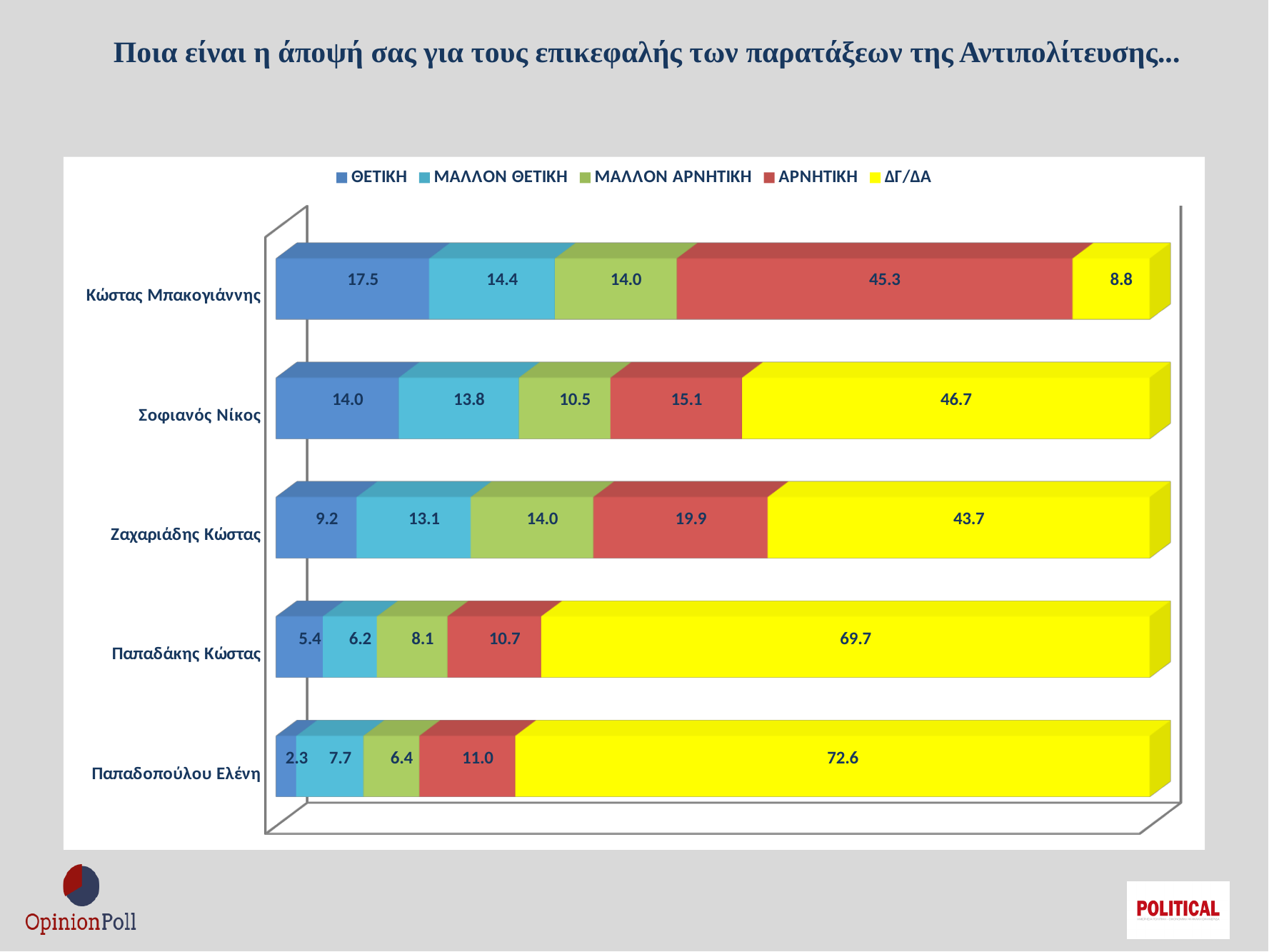
What kind of chart is shown on the slide? Stacked bar chart Which person has the lowest ΔΓ/ΔΑ value? Κώστας Μπακογιάννης What is the ΑΡΝΗΤΙΚΗ value for Κώστας Μπακογιάννης? 45.3 How many series does the legend list? 5 What is the ΜΑΛΛΟΝ ΘΕΤΙΚΗ value for Ζαχαριάδης Κώστας? 13.1 How many people (categories) are shown in the chart? 5 What is the total of the stacked bar for Κώστας Μπακογιάννης? 100.0 Which person has the highest ΘΕΤΙΚΗ value? Κώστας Μπακογιάννης What is the difference between the ΑΡΝΗΤΙΚΗ values for Κώστας Μπακογιάννης and Σοφιανός Νίκος? 30.2 Which is larger: the ΔΓ/ΔΑ value for Παπαδοπούλου Ελένη or for Παπαδάκης Κώστας? Παπαδοπούλου Ελένη What is the ΔΓ/ΔΑ value for Παπαδάκης Κώστας? 69.7 Which colour represents the ΔΓ/ΔΑ series in the legend? Yellow